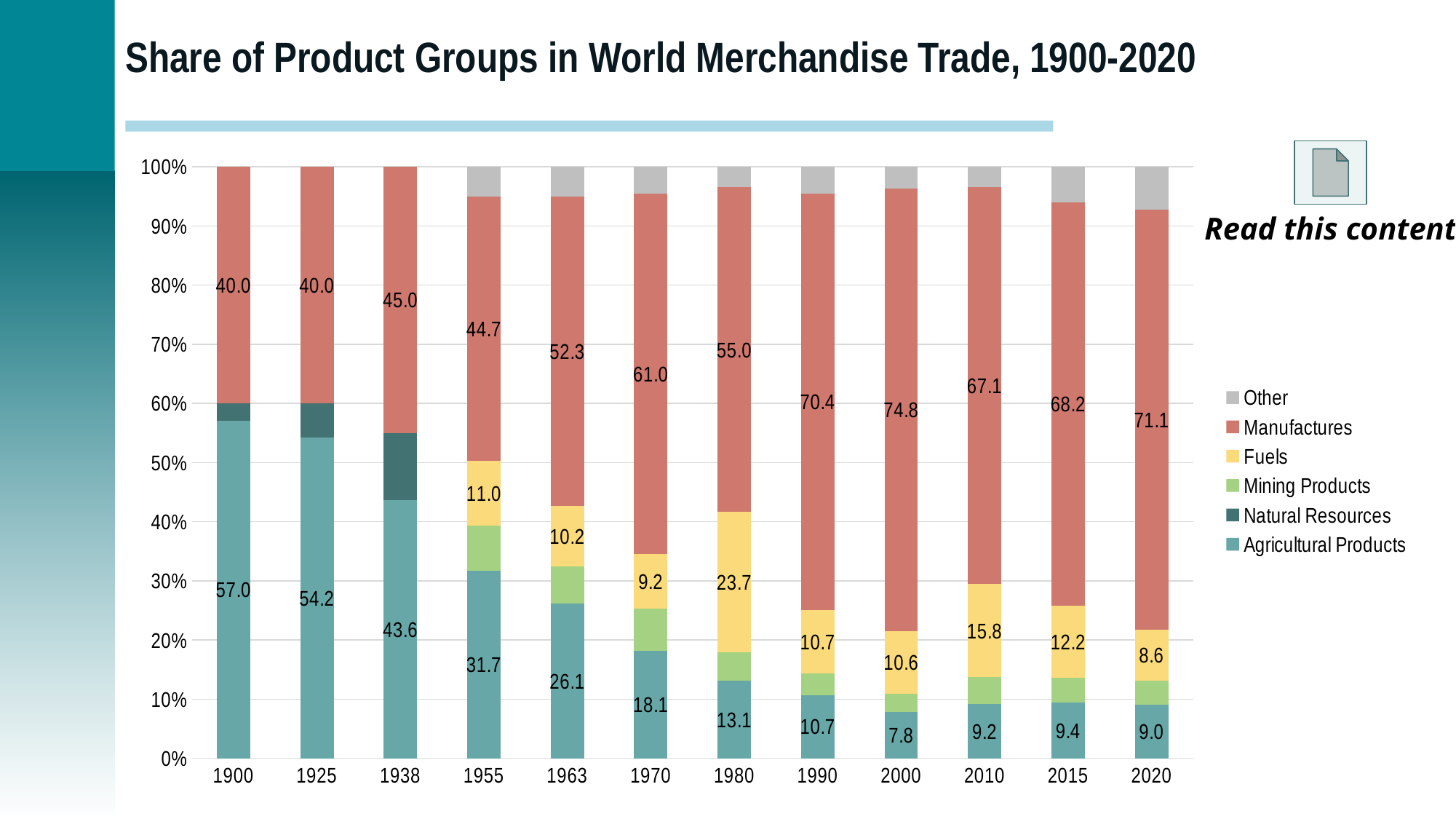
What kind of chart is shown on the slide? Stacked bar chart In which year is the share of Fuels highest? 1980 In which year is the share of Manufactures highest? 2000 How many years are shown on the x axis? 12 What is the share of Agricultural Products in 1900? 57.0 What is the share of Fuels in 2015? 12.2 Which year has a larger Fuels share, 1980 or 2010? 1980 Does the share of Agricultural Products rise or fall from 1900 to 2000? Fall How many series does the legend list? 6 What is the share of Manufactures in 2000? 74.8 In which year is the share of Agricultural Products lowest? 2000 What is the difference between the Agricultural Products share in 1900 and in 2020? 48.0